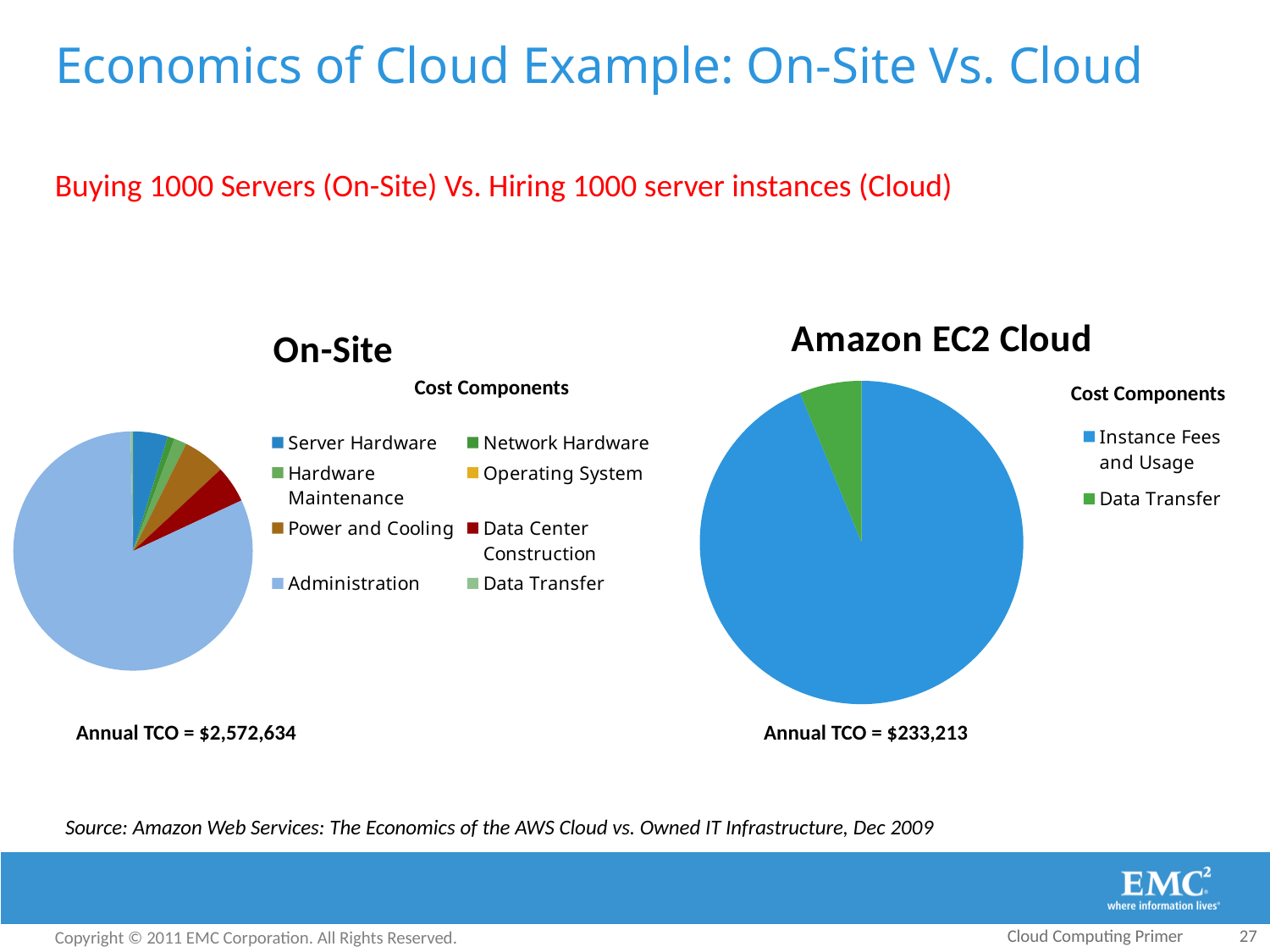
What is the Annual TCO shown under the Amazon EC2 Cloud chart? $233,213 In the Amazon EC2 Cloud chart, which is larger: Instance Fees and Usage or Data Transfer? Instance Fees and Usage In the On-Site chart, which cost component has the largest slice? Administration What is the Annual TCO shown under the On-Site chart? $2,572,634 In the On-Site chart, which is larger: Power and Cooling or Data Transfer? Power and Cooling In the Amazon EC2 Cloud chart, how many cost components does the legend list? 2 What kind of chart is the On-Site chart? Pie chart In the On-Site chart, how many cost components does the legend list? 8 In the On-Site chart, which is larger: Administration or Server Hardware? Administration In the Amazon EC2 Cloud chart, which cost component has the largest slice? Instance Fees and Usage What kind of chart is the Amazon EC2 Cloud chart? Pie chart In the Amazon EC2 Cloud chart, which cost component has the smallest slice? Data Transfer